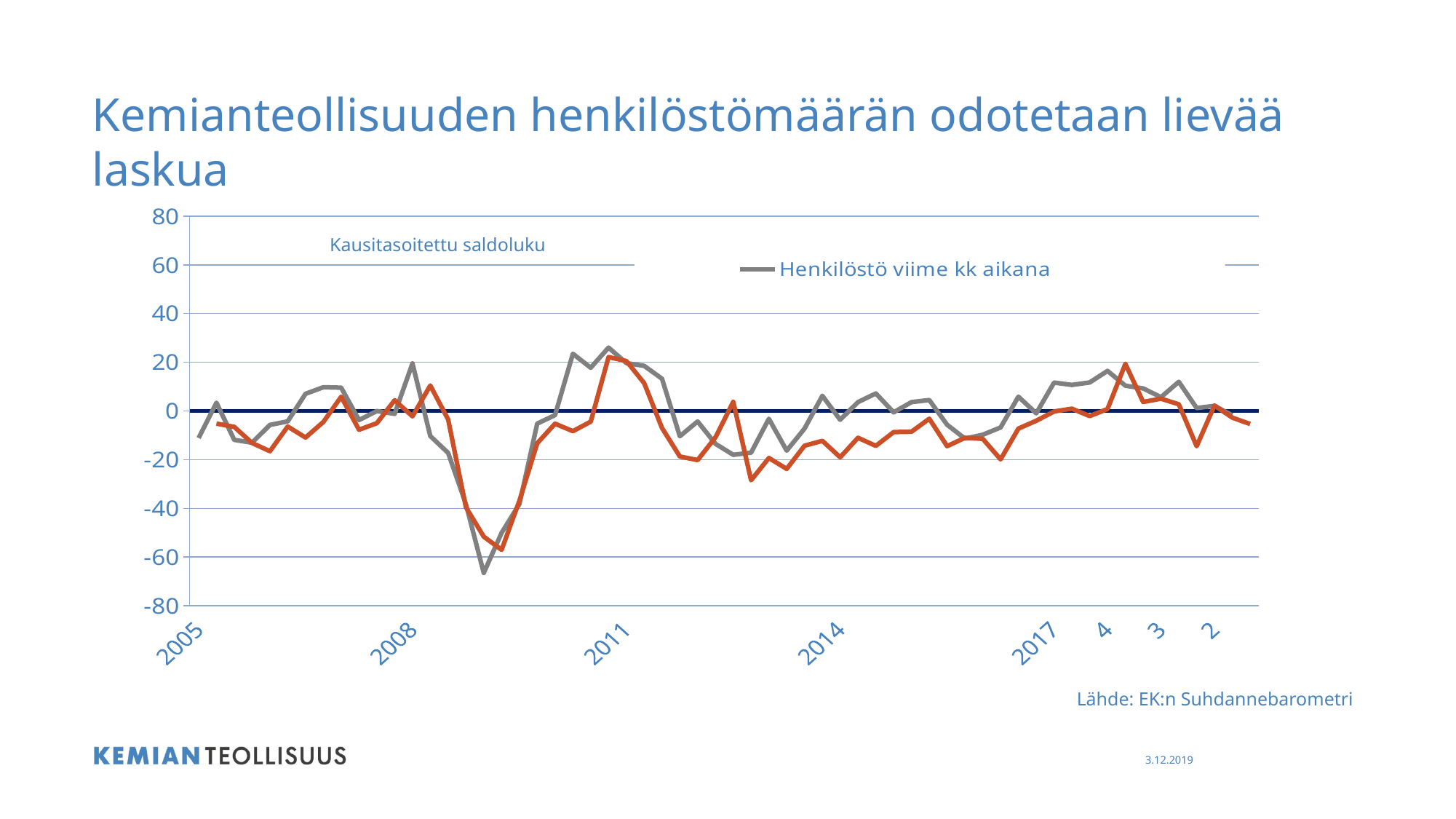
Is the value of the grey 'Henkilöstö viime kk aikana' line at the start of the series in 2005 greater or less than 0? less Is the lowest value of the orange line around 2013 greater or less than -20? less Between 2008 and 2009, does the grey 'Henkilöstö viime kk aikana' line rise or fall? fall Is the peak of the grey 'Henkilöstö viime kk aikana' line around 2017–2018 greater or less than 0? greater What source is cited for the chart data? EK:n Suhdannebarometri Between 2009 and 2011, does the grey 'Henkilöstö viime kk aikana' line rise or fall overall? rise What colour is the 'Henkilöstö viime kk aikana' line in the chart? grey What kind of chart is shown on the slide? line chart